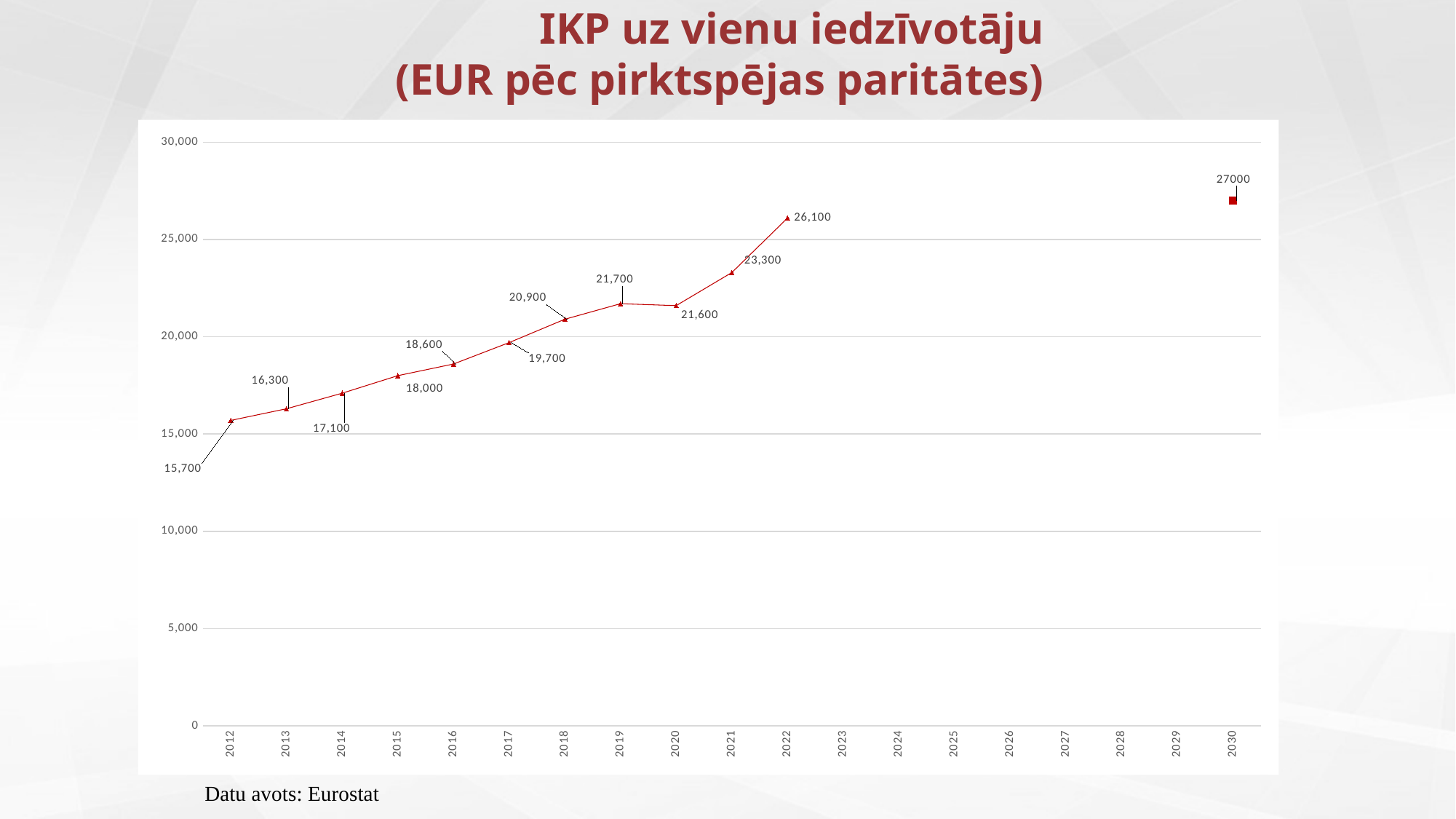
What kind of chart is shown on the slide? Line chart What value is shown for 2030? 27000 What is the difference between the values for 2019 and 2020? 100 What is the difference between the values for 2022 and 2021? 2,800 Which is larger, the value for 2019 or the value for 2020? 2019 Which year between 2012 and 2022 has the lowest value? 2012 Which year between 2012 and 2022 has the highest value? 2022 What is the value for 2017? 19,700 What is the value for 2022? 26,100 Do the values generally rise or fall from 2012 to 2022? Rise What is the value for 2012? 15,700 How many data points are plotted on the line from 2012 to 2022? 11